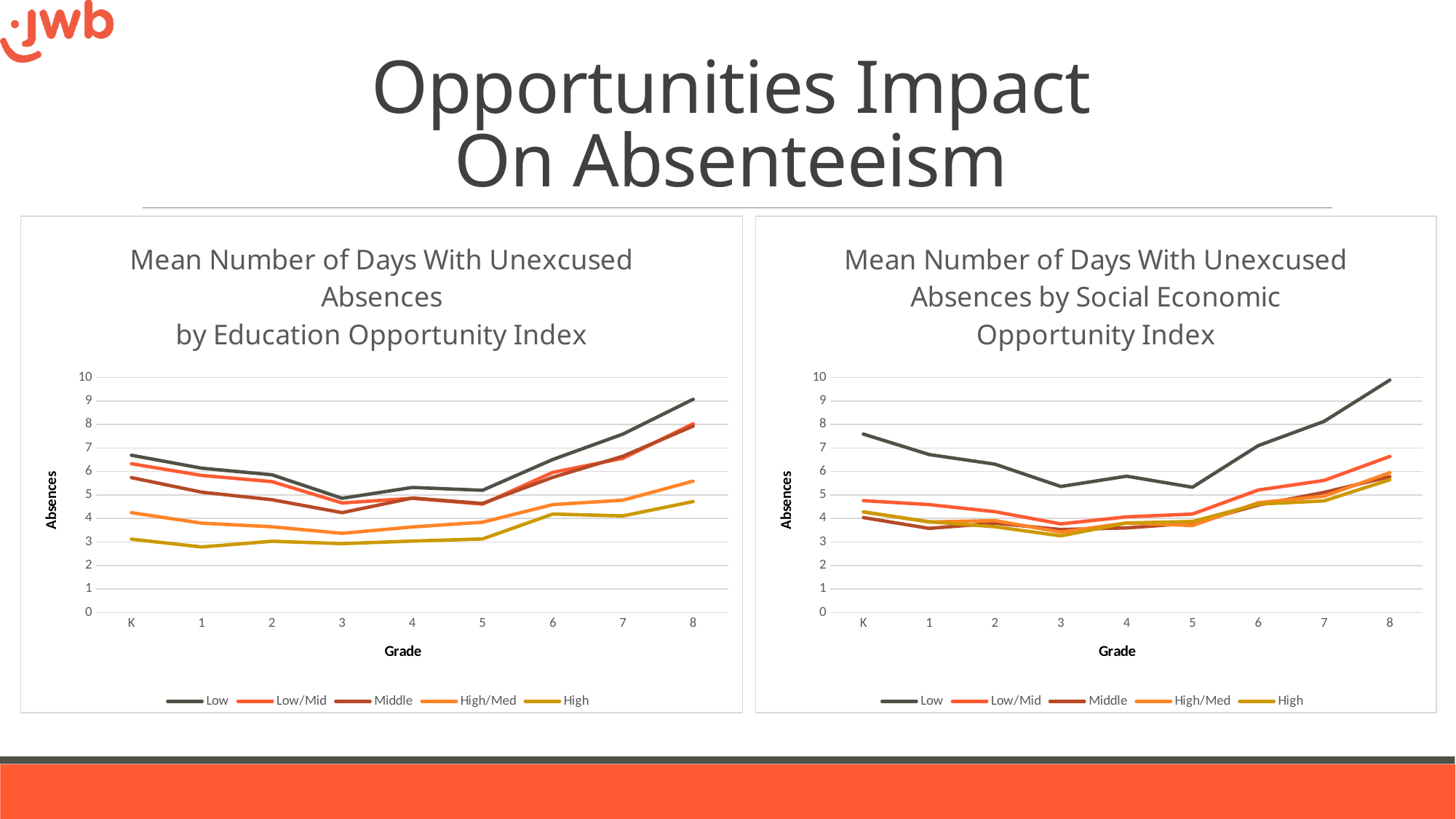
In the left chart, which series has the highest value at grade 8? Low What kind of chart is the left chart, 'Mean Number of Days With Unexcused Absences by Education Opportunity Index'? line chart How many series does the legend of the right chart, 'Mean Number of Days With Unexcused Absences by Social Economic Opportunity Index', list? 5 In the right chart, does the Low series rise or fall from grade 5 to grade 8? rise In the right chart, which series has the highest value at grade 8? Low In the left chart, is the value for the High series at grade 1 greater or less than 3? less In the right chart, is the value for the Low series at grade K greater or less than 7? greater In the right chart, is the value for the Low series at grade 8 greater or less than 9? greater In the left chart, which series has the lowest value at grade K? High How many grade levels are plotted along the x axis of the left chart? 9 What is the label on the y axis of the right chart? Absences